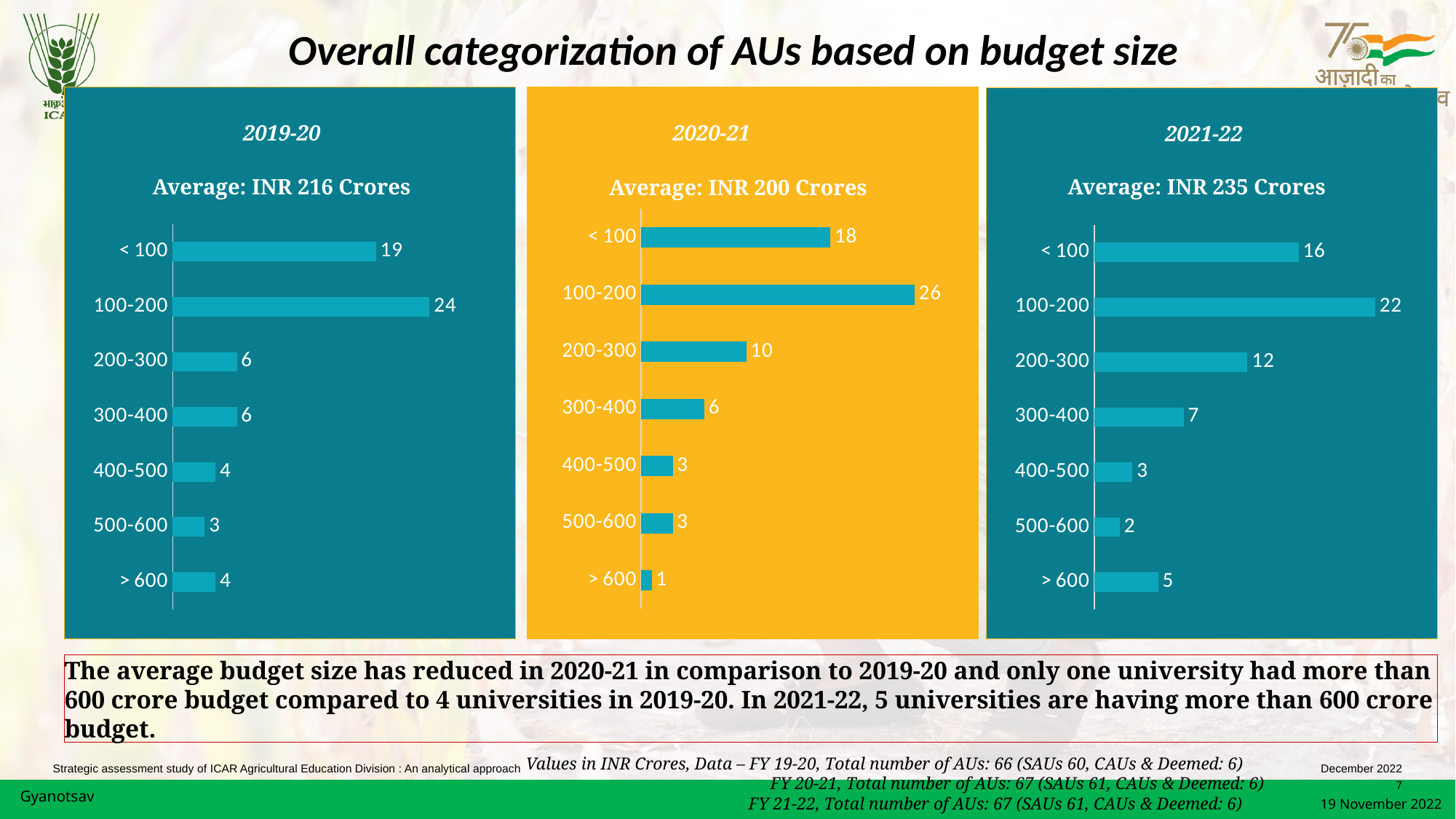
How many categories does the 2020-21 chart show? 7 In the 2021-22 chart, which category has the lowest value? 500-600 What average budget is stated in the title of the 2021-22 chart? INR 235 Crores In the 2019-20 chart, what is the value for the 100-200 category? 24 In the 2021-22 chart, which is larger, the value for 300-400 or the value for > 600? 300-400 Which of the three charts has a yellow background? 2020-21 In the 2020-21 chart, which category has the highest value? 100-200 In the 2021-22 chart, what is the value for the 200-300 category? 12 In the 2019-20 chart, what is the difference between the values for < 100 and 100-200? 5 What kind of chart is the 2019-20 chart? Bar chart In the 2020-21 chart, what is the total of the values for 400-500 and 500-600? 6 In the 2020-21 chart, what is the value for the > 600 category? 1